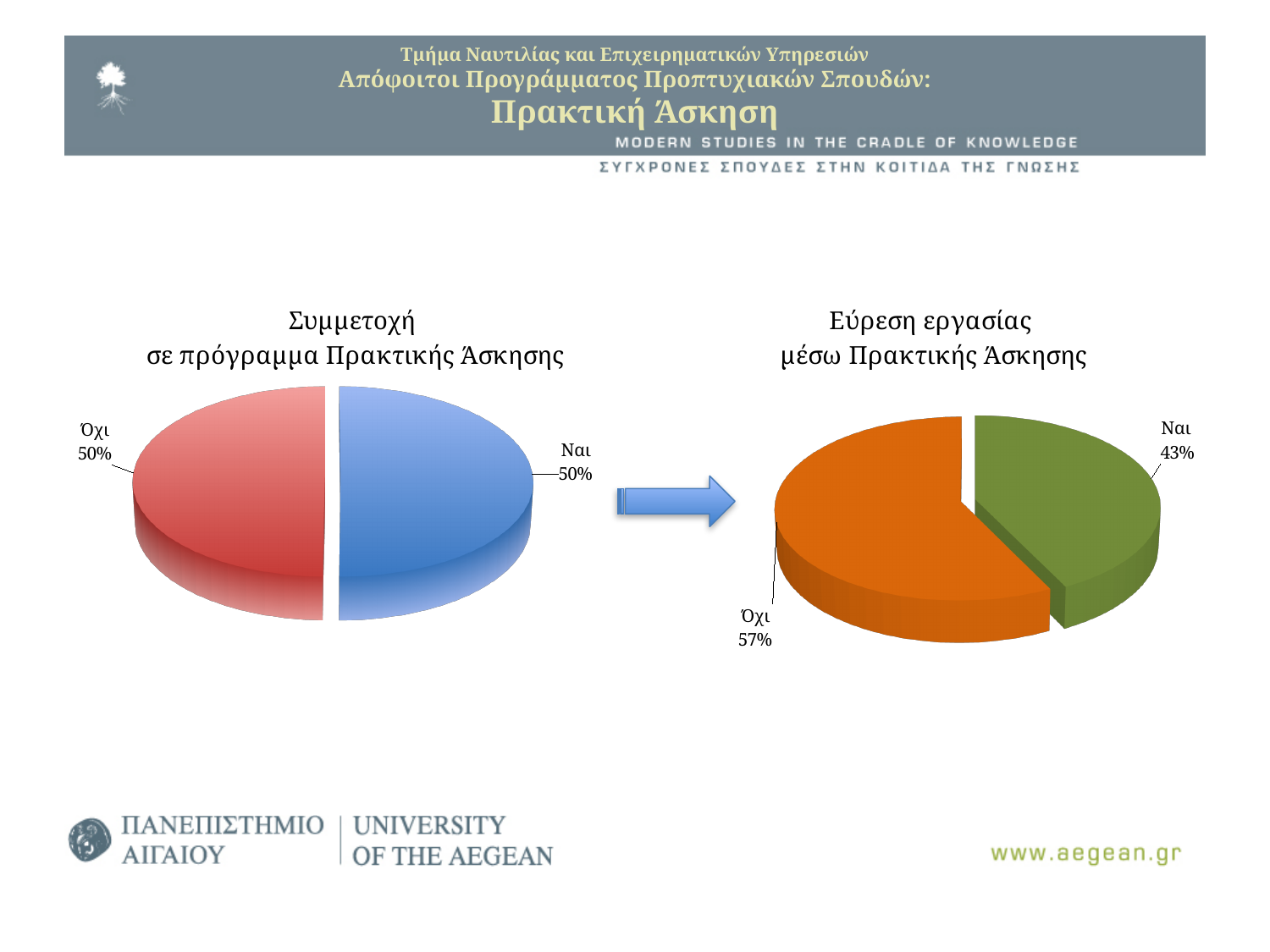
In the right chart (Εύρεση εργασίας μέσω Πρακτικής Άσκησης), what share is labelled for Ναι? 43% How many pie charts are shown on the slide? 2 In the left chart (Συμμετοχή σε πρόγραμμα Πρακτικής Άσκησης), what colour is the Ναι slice? Blue In the right chart (Εύρεση εργασίας μέσω Πρακτικής Άσκησης), what is the difference in percentage points between Όχι and Ναι? 14 percentage points In the left chart (Συμμετοχή σε πρόγραμμα Πρακτικής Άσκησης), what share is labelled for Ναι? 50% In the left chart (Συμμετοχή σε πρόγραμμα Πρακτικής Άσκησης), what share is labelled for Όχι? 50% How many slices does the right chart (Εύρεση εργασίας μέσω Πρακτικής Άσκησης) have? 2 In the right chart (Εύρεση εργασίας μέσω Πρακτικής Άσκησης), what share is labelled for Όχι? 57% In the right chart (Εύρεση εργασίας μέσω Πρακτικής Άσκησης), which slice is the largest? Όχι What type of chart is the left chart (Συμμετοχή σε πρόγραμμα Πρακτικής Άσκησης)? Pie chart In the right chart (Εύρεση εργασίας μέσω Πρακτικής Άσκησης), which is larger, Ναι or Όχι? Όχι In the right chart (Εύρεση εργασίας μέσω Πρακτικής Άσκησης), which slice is the smallest? Ναι